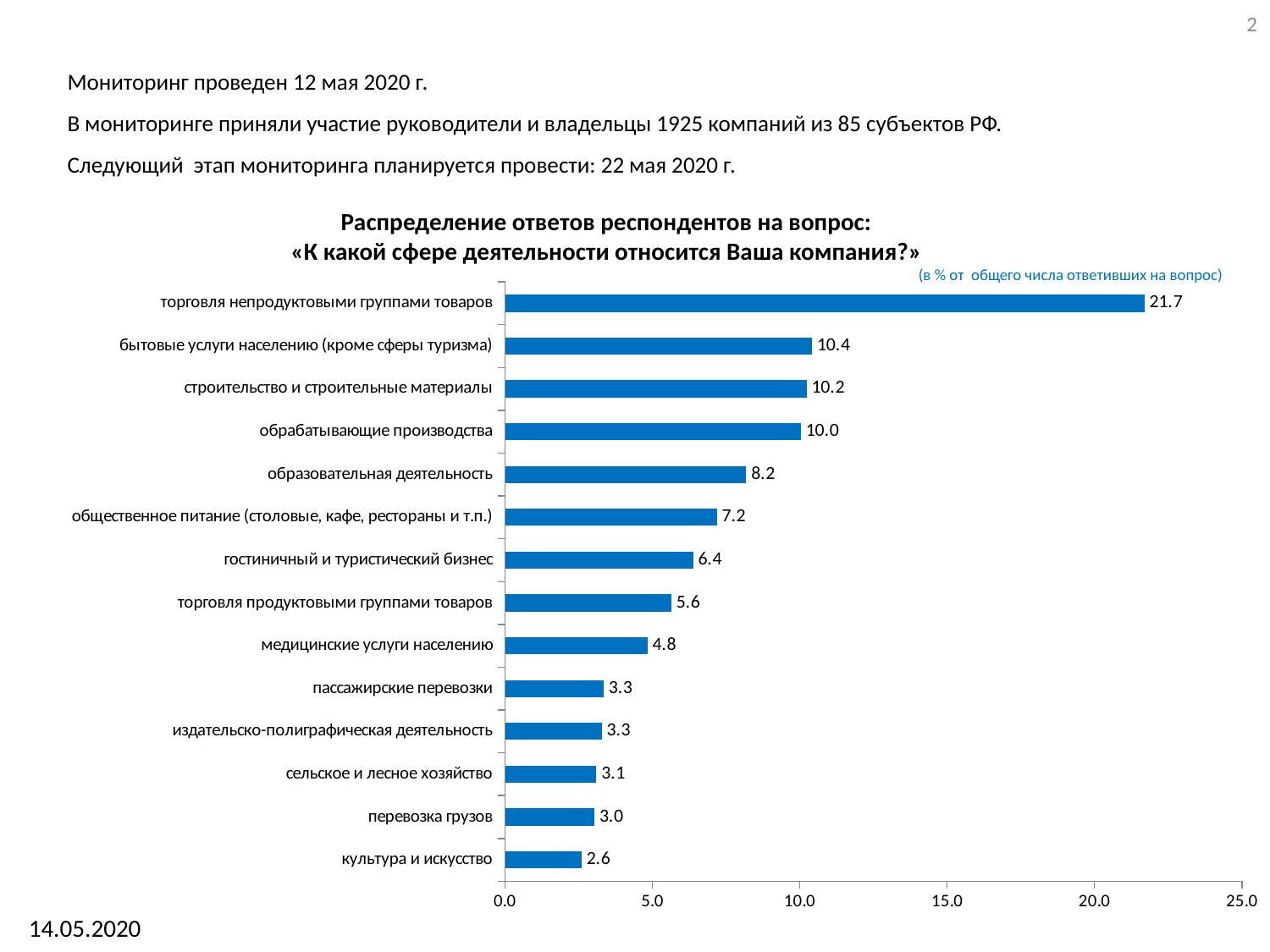
What kind of chart is shown on the slide? bar chart What value is shown for «медицинские услуги населению»? 4.8 Is the value for «общественное питание (столовые, кафе, рестораны и т.п.)» greater or less than 10.0? less What is the difference between the values for «перевозка грузов» and «культура и искусство»? 0.4 What is the difference between the values for «торговля непродуктовыми группами товаров» and «бытовые услуги населению (кроме сферы туризма)»? 11.3 Which category has the lowest value? культура и искусство What value is shown for «торговля непродуктовыми группами товаров»? 21.7 Which is larger: the value for «гостиничный и туристический бизнес» or for «торговля продуктовыми группами товаров»? гостиничный и туристический бизнес How many categories are shown in the chart? 14 What is the maximum value shown on the horizontal axis of the chart? 25.0 Which category has the highest value? торговля непродуктовыми группами товаров What value is shown for «образовательная деятельность»? 8.2